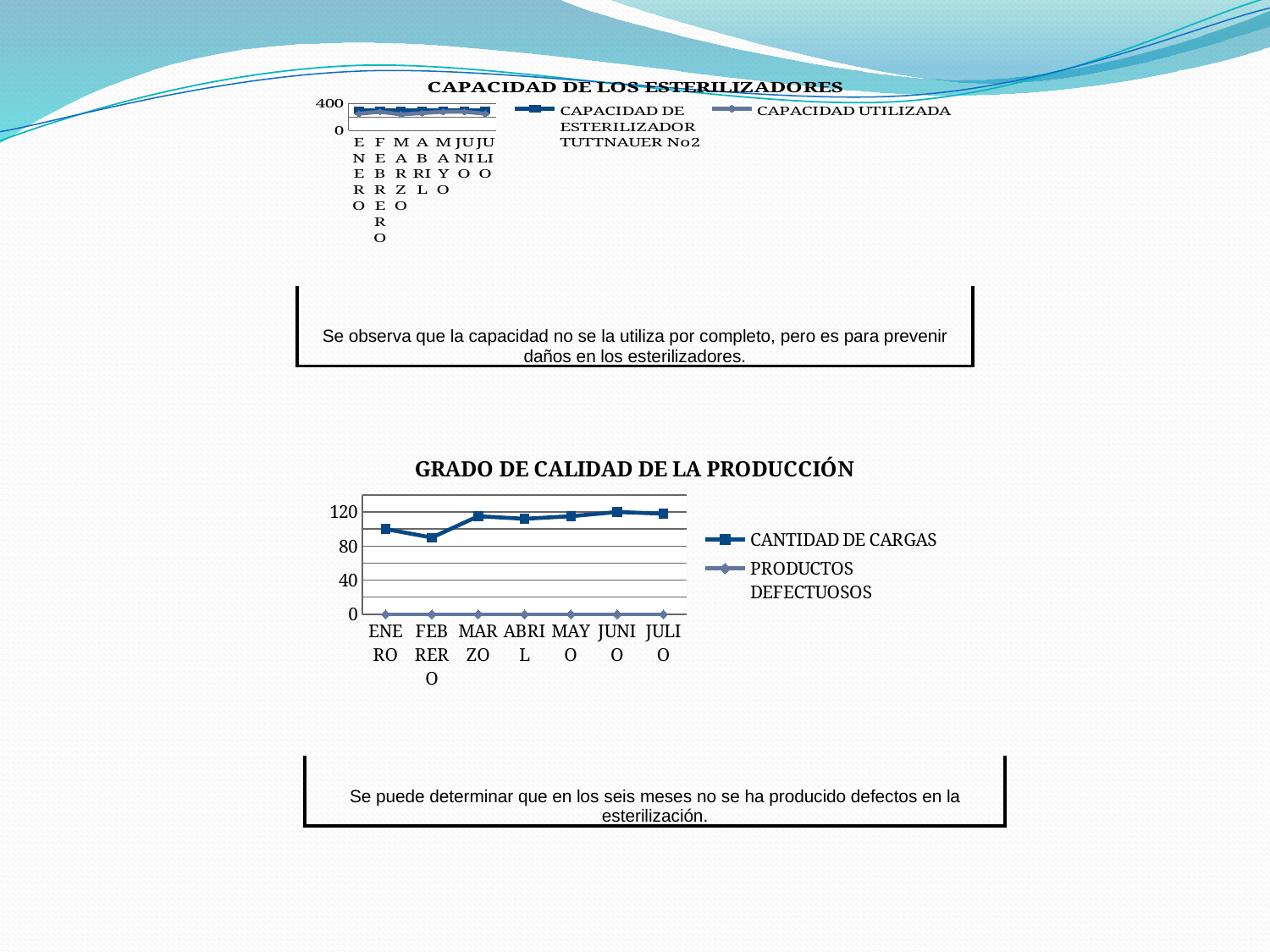
What are the two legend entries of the 'GRADO DE CALIDAD DE LA PRODUCCIÓN' chart? CANTIDAD DE CARGAS and PRODUCTOS DEFECTUOSOS In the 'GRADO DE CALIDAD DE LA PRODUCCIÓN' chart, is the CANTIDAD DE CARGAS for FEBRERO greater or less than 120? less How many series does the legend of the 'GRADO DE CALIDAD DE LA PRODUCCIÓN' chart list? 2 What kind of chart is the 'GRADO DE CALIDAD DE LA PRODUCCIÓN' chart? line chart In the 'GRADO DE CALIDAD DE LA PRODUCCIÓN' chart, is the CANTIDAD DE CARGAS for ENERO greater or less than 80? greater How many series does the legend of the 'CAPACIDAD DE LOS ESTERILIZADORES' chart list? 2 In the 'GRADO DE CALIDAD DE LA PRODUCCIÓN' chart, which month has the lowest CANTIDAD DE CARGAS? FEBRERO In the 'GRADO DE CALIDAD DE LA PRODUCCIÓN' chart, which month has the larger CANTIDAD DE CARGAS, ENERO or FEBRERO? ENERO In the 'GRADO DE CALIDAD DE LA PRODUCCIÓN' chart, what is the value of PRODUCTOS DEFECTUOSOS in MARZO? 0 In the 'GRADO DE CALIDAD DE LA PRODUCCIÓN' chart, does CANTIDAD DE CARGAS rise or fall from FEBRERO to MARZO? rise How many months are shown on the x axis of the 'GRADO DE CALIDAD DE LA PRODUCCIÓN' chart? 7 What kind of chart is the 'CAPACIDAD DE LOS ESTERILIZADORES' chart at the top of the slide? line chart